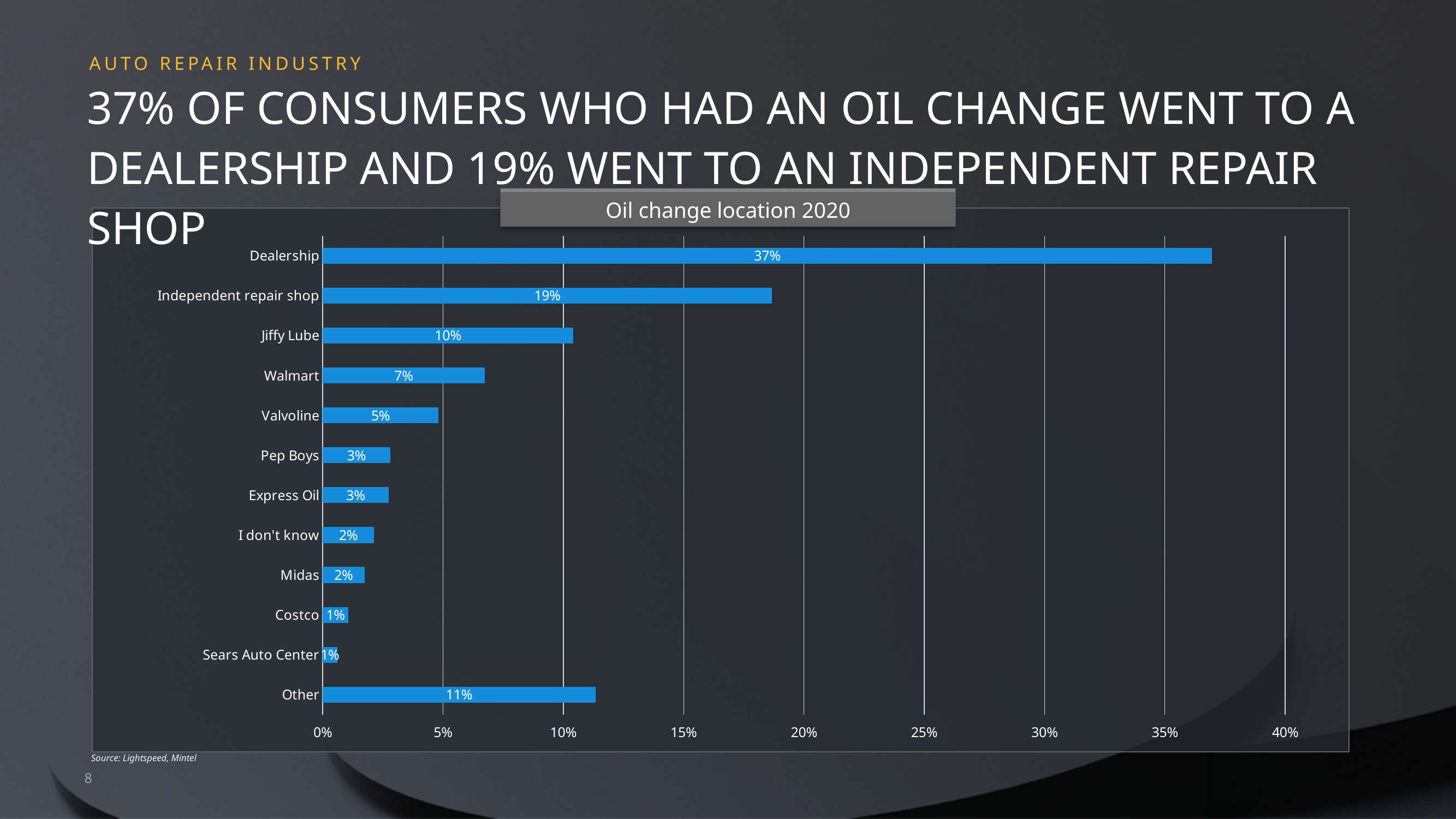
What is the value shown for Other? 11% What type of chart is shown on the slide? Bar chart What is the difference between the Jiffy Lube and Walmart values? 3% What is the title of the chart? Oil change location 2020 How many oil change locations are listed in the chart? 12 Which is larger, the value for Other or the value for Jiffy Lube? Other What is the difference between the Dealership and Independent repair shop values? 18% What is the value shown for Walmart? 7% Is the value for Dealership greater or less than 35%? greater What percentage of consumers went to a Dealership for an oil change? 37% Which oil change location has the highest percentage? Dealership What is the value shown for Jiffy Lube? 10%